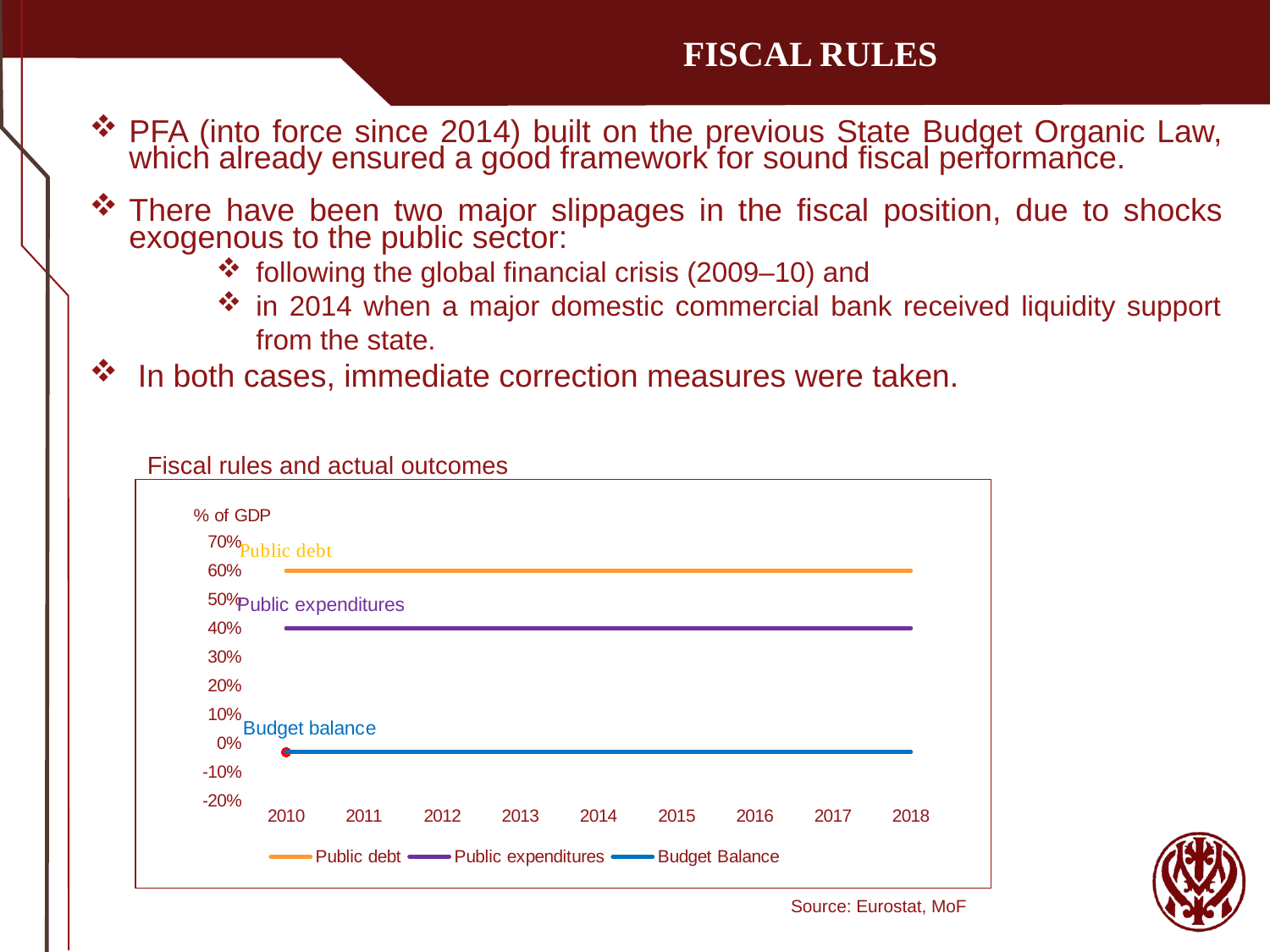
What colour is the Budget Balance line in the chart? blue Which series has the lowest values in the chart? Budget Balance What unit is given on the y axis of the chart? % of GDP Is the Public expenditures line greater or less than 50% of GDP? less How many years are shown on the x axis of the chart? 9 Which is larger in the chart, Public debt or Public expenditures? Public debt Which series has the highest values in the chart? Public debt Is the Budget Balance line greater or less than 10% of GDP? less How many series does the legend of the chart list? 3 Is the Public debt line greater or less than 50% of GDP? greater What kind of chart is shown under 'Fiscal rules and actual outcomes'? line chart Do the values of the Public debt line rise, fall or stay flat from 2010 to 2018? stay flat